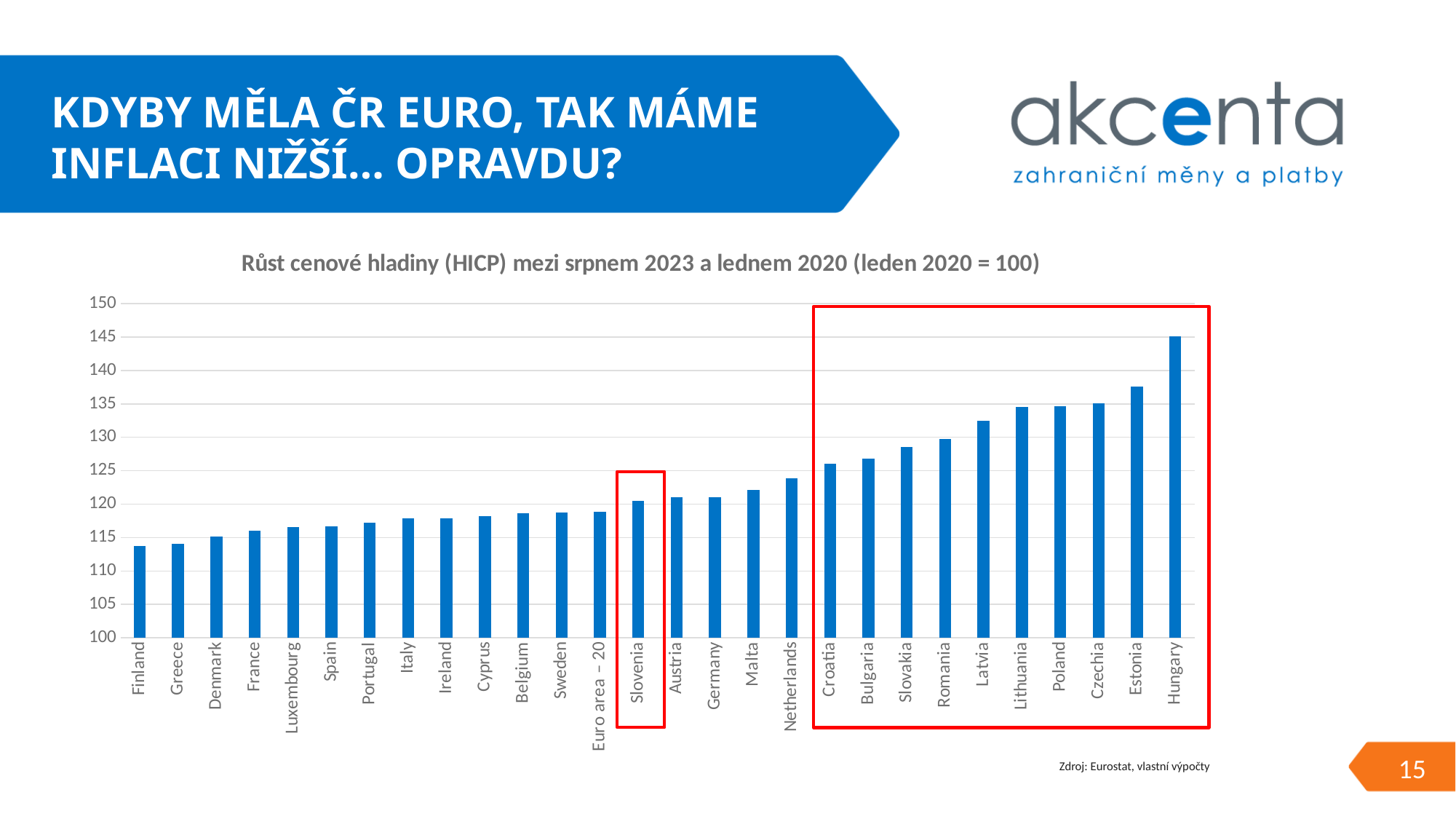
What is the title of the chart? Růst cenové hladiny (HICP) mezi srpnem 2023 a lednem 2020 (leden 2020 = 100) What kind of chart is shown on the slide? bar chart Is the value for Hungary greater or less than 140? greater Is the value for Finland greater or less than 115? less Which country has the lowest price level growth on the chart? Finland Which has a higher value, Czechia or Slovenia? Czechia Is the value for Netherlands greater or less than 125? less Which has a higher value, Latvia or Romania? Latvia Which country has the highest price level growth on the chart? Hungary How many countries or regions are plotted on the chart? 28 Do the values rise or fall moving from left to right along the x axis? rise